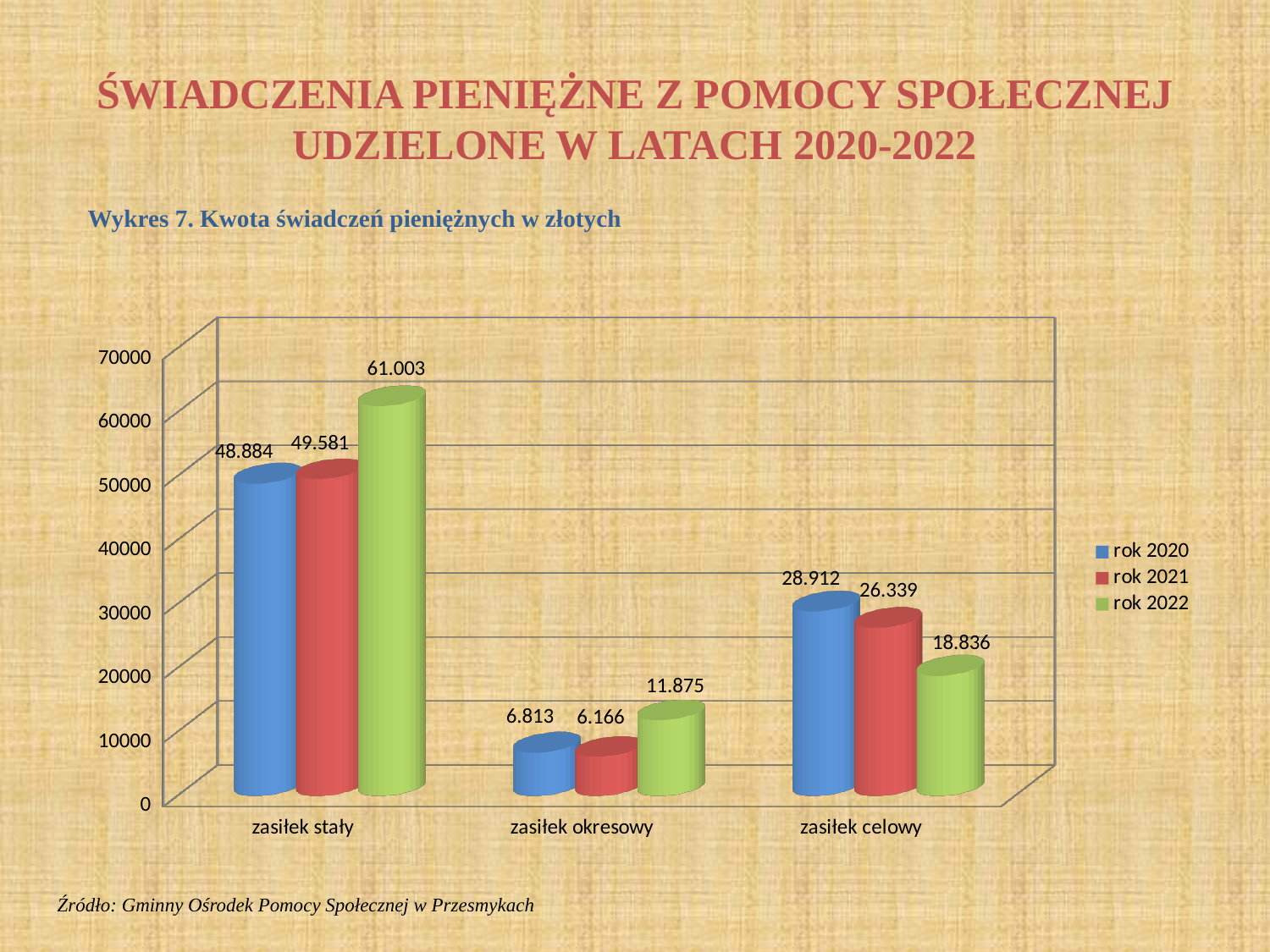
How many series does the legend list? 3 What kind of chart is shown on the slide? bar chart How many categories are shown on the x axis? 3 Which is larger for zasiłek celowy: the rok 2021 value or the rok 2022 value? rok 2021 Which category has the lowest value in rok 2020? zasiłek okresowy What is the value for zasiłek okresowy in rok 2021? 6.166 Which category has the highest value in rok 2022? zasiłek stały What is the value for zasiłek celowy in rok 2020? 28.912 What is the difference between the rok 2022 and rok 2020 values for zasiłek stały? 12.119 What is the value for zasiłek stały in rok 2022? 61.003 What is the difference between the rok 2020 and rok 2022 values for zasiłek celowy? 10.076 Do the values for zasiłek celowy rise or fall from rok 2020 to rok 2022? fall